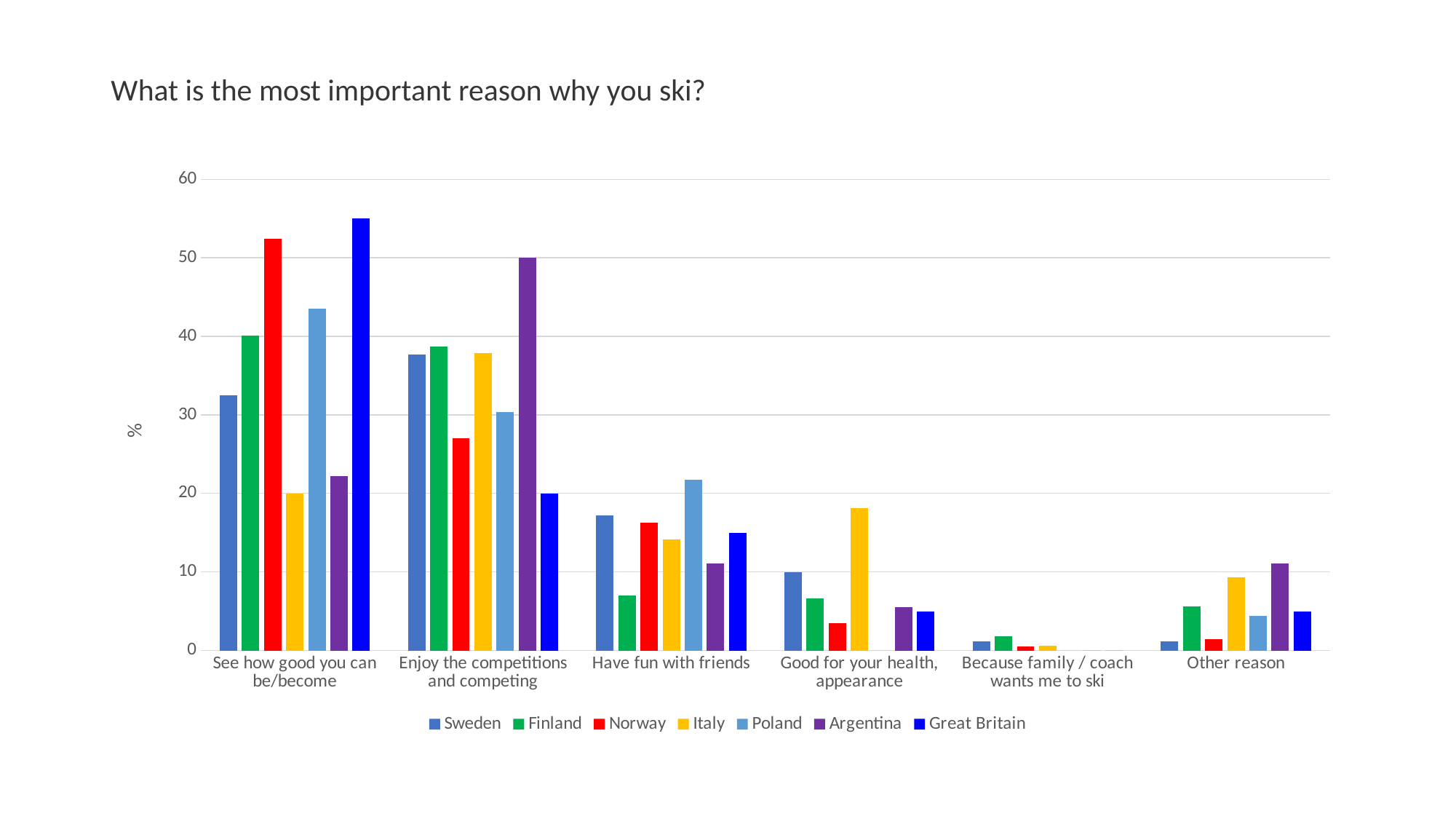
Is the value for Great Britain under 'Enjoy the competitions and competing' greater or less than 30? less How many countries does the legend list? 7 Which country has the highest value for 'Good for your health, appearance'? Italy Which country has the highest value for 'Have fun with friends'? Poland How many reason categories are shown along the x axis? 6 Is the value for Norway under 'See how good you can be/become' greater or less than 50? greater Which country has the highest value for 'Enjoy the competitions and competing'? Argentina What is the label on the vertical axis? % What kind of chart is shown on the slide? Bar chart For 'Have fun with friends', which is larger: the value for Sweden or the value for Finland? Sweden Which country has the lowest value for 'Have fun with friends'? Finland